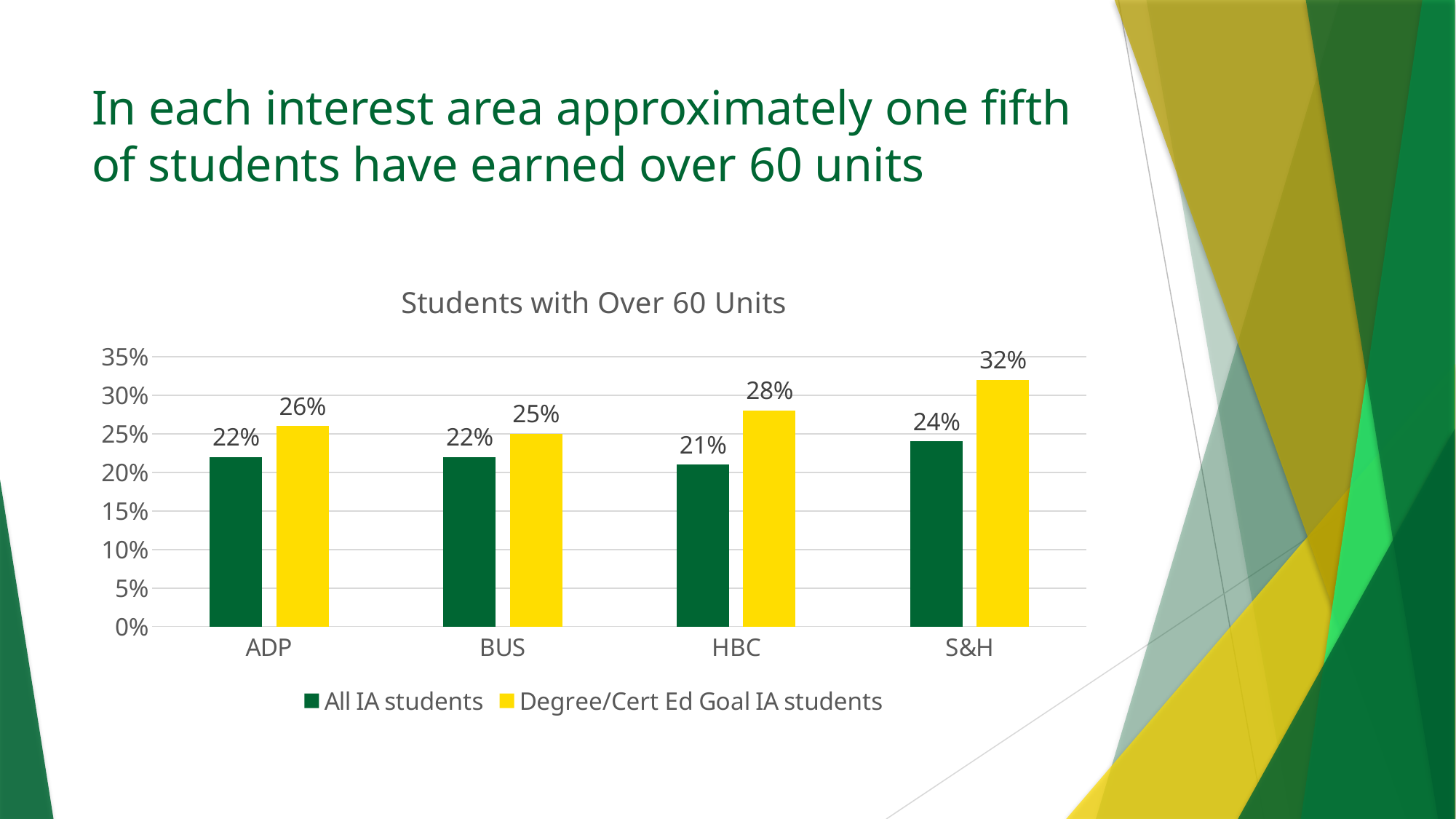
What is the value for All IA students in the ADP category? 22% What is the difference between the Degree/Cert Ed Goal IA students value and the All IA students value in the S&H category? 8% Which category has the lowest value for All IA students? HBC How many categories are shown on the x axis? 4 Is the value for Degree/Cert Ed Goal IA students in the S&H category greater or less than 30%? greater What kind of chart is shown on the slide? Bar chart How many series does the legend list? 2 What is the value for Degree/Cert Ed Goal IA students in the S&H category? 32% What is the title of the chart? Students with Over 60 Units Which is larger in the BUS category: All IA students or Degree/Cert Ed Goal IA students? Degree/Cert Ed Goal IA students Which category has the highest value for Degree/Cert Ed Goal IA students? S&H What is the value for Degree/Cert Ed Goal IA students in the HBC category? 28%